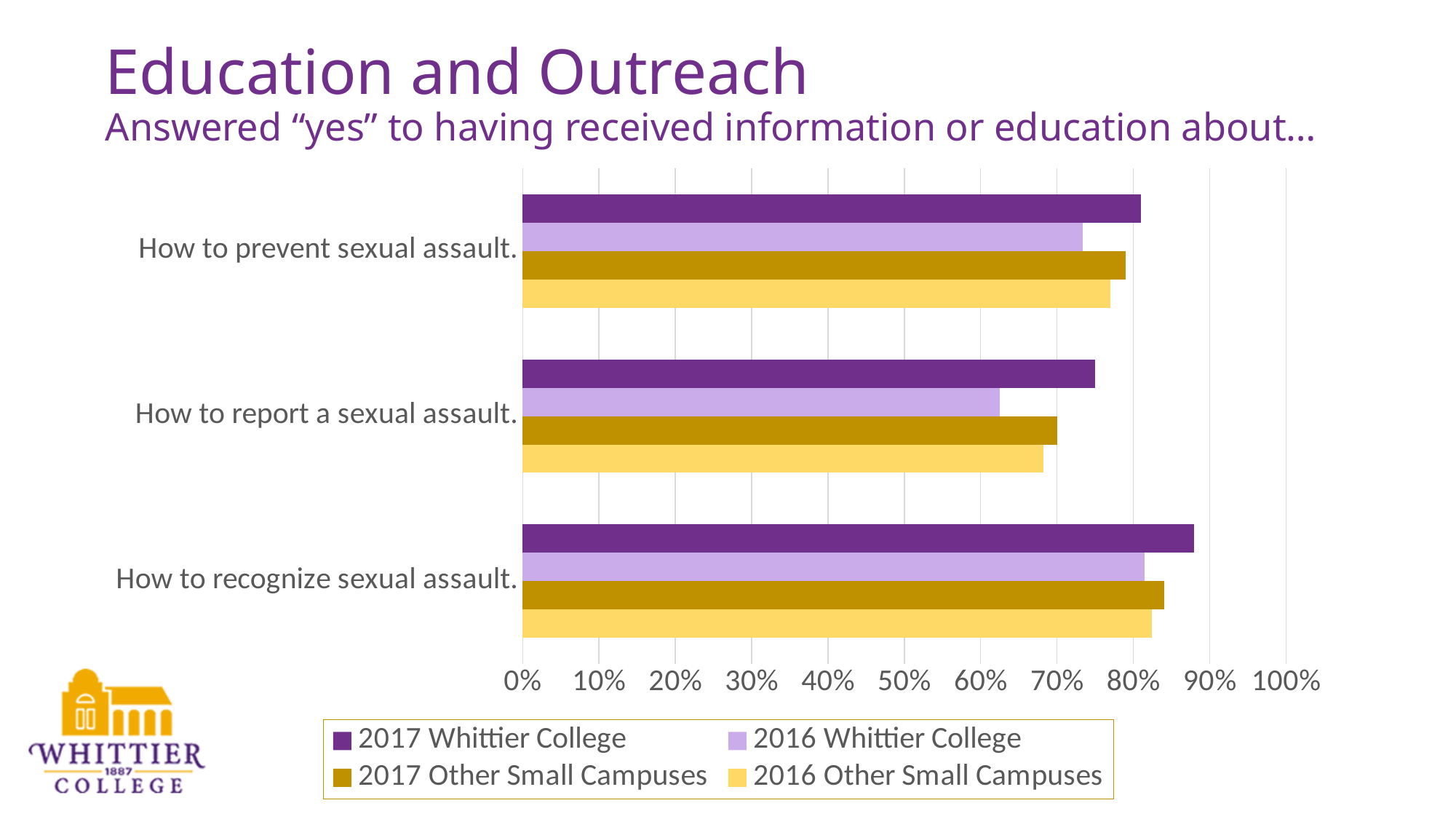
How many series does the legend list? 4 How many categories are shown on the chart? 3 For "How to report a sexual assault.", which is larger: 2017 Whittier College or 2016 Whittier College? 2017 Whittier College For which category is the 2016 Whittier College value lowest? How to report a sexual assault. Is the value for 2016 Whittier College on "How to report a sexual assault." greater or less than 70%? less Is the value for 2017 Whittier College on "How to recognize sexual assault." greater or less than 80%? greater Which series is shown in dark purple in the legend? 2017 Whittier College Is the value for 2017 Whittier College on "How to report a sexual assault." greater or less than 70%? greater For "How to report a sexual assault.", which series has the lowest value? 2016 Whittier College What kind of chart is shown on the slide? bar chart For which category is the 2017 Whittier College value highest? How to recognize sexual assault.